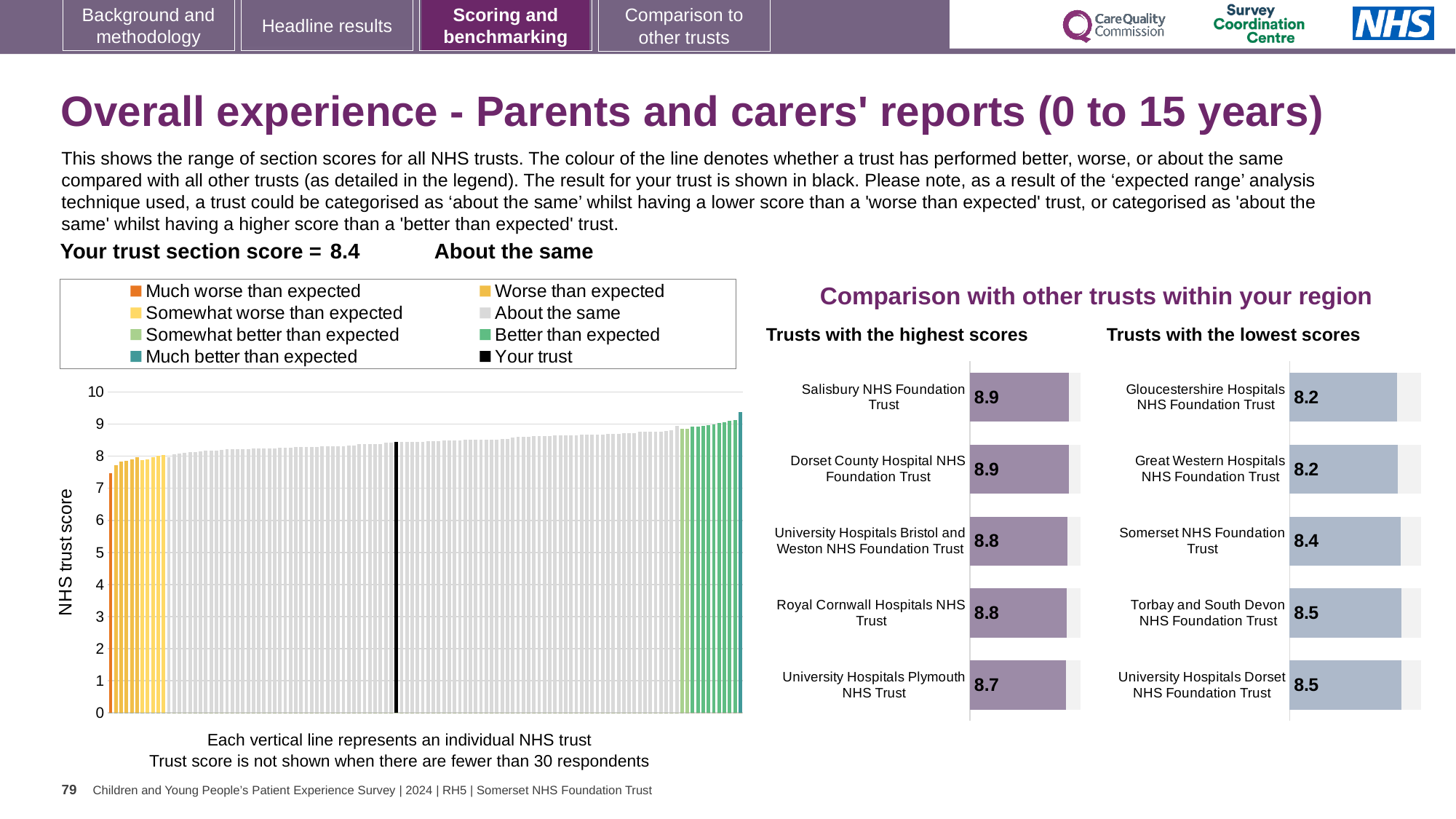
How many trusts are shown in the 'Trusts with the lowest scores' chart? 5 What kind of chart is the large chart on the left showing all NHS trusts? bar chart How many entries does the legend above the large chart on the left list? 8 In the 'Trusts with the highest scores' chart, what is the score for University Hospitals Plymouth NHS Trust? 8.7 In the large chart on the left, is the value for the black 'Your trust' bar greater or less than 8? greater In the 'Trusts with the lowest scores' chart, what is the score for Somerset NHS Foundation Trust? 8.4 In the 'Trusts with the lowest scores' chart, which has the higher score: Somerset NHS Foundation Trust or Torbay and South Devon NHS Foundation Trust? Torbay and South Devon NHS Foundation Trust In the 'Trusts with the lowest scores' chart, what is the difference between the scores of Somerset NHS Foundation Trust and Gloucestershire Hospitals NHS Foundation Trust? 0.2 In the 'Trusts with the highest scores' chart, what is the difference between the scores of Salisbury NHS Foundation Trust and University Hospitals Plymouth NHS Trust? 0.2 In the 'Trusts with the highest scores' chart, which trust has the lowest score? University Hospitals Plymouth NHS Trust In the large chart on the left, is the value for the lowest-scoring trust (the leftmost bar) greater or less than 8? less In the large chart on the left, what is the label on the vertical axis? NHS trust score